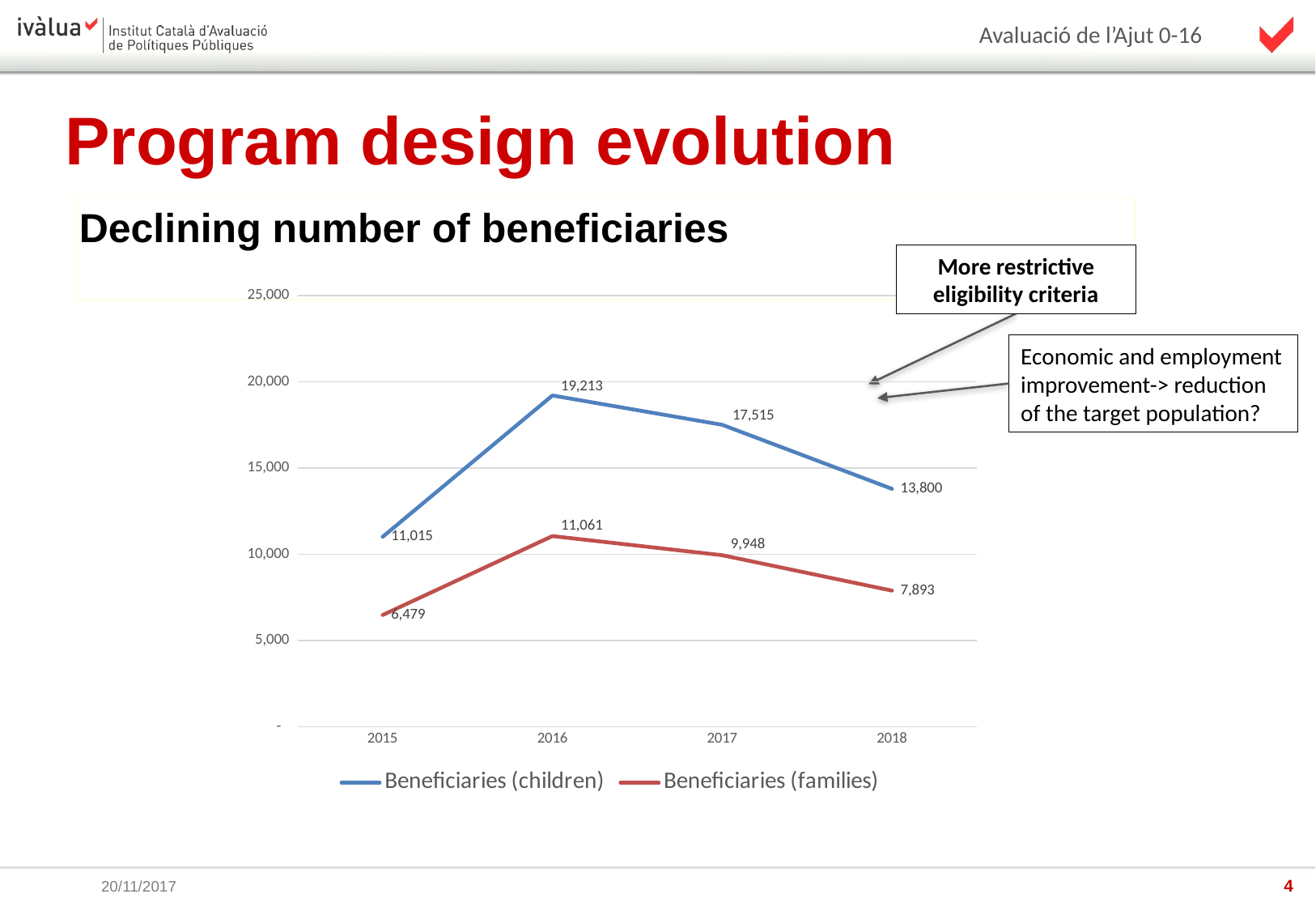
In which year is Beneficiaries (children) lowest? 2015 What is the value for Beneficiaries (children) in 2015? 11,015 In which year is Beneficiaries (families) highest? 2016 Does Beneficiaries (children) rise or fall from 2016 to 2018? fall What is the difference between Beneficiaries (children) and Beneficiaries (families) in 2017? 7,567 How many series does the legend list? 2 Which is larger: Beneficiaries (families) in 2015 or in 2018? 2018 What is the value for Beneficiaries (families) in 2018? 7,893 How many years are shown on the x axis? 4 What is the value for Beneficiaries (children) in 2016? 19,213 Is the value for Beneficiaries (children) in 2018 greater or less than 15,000? less What kind of chart is shown? line chart